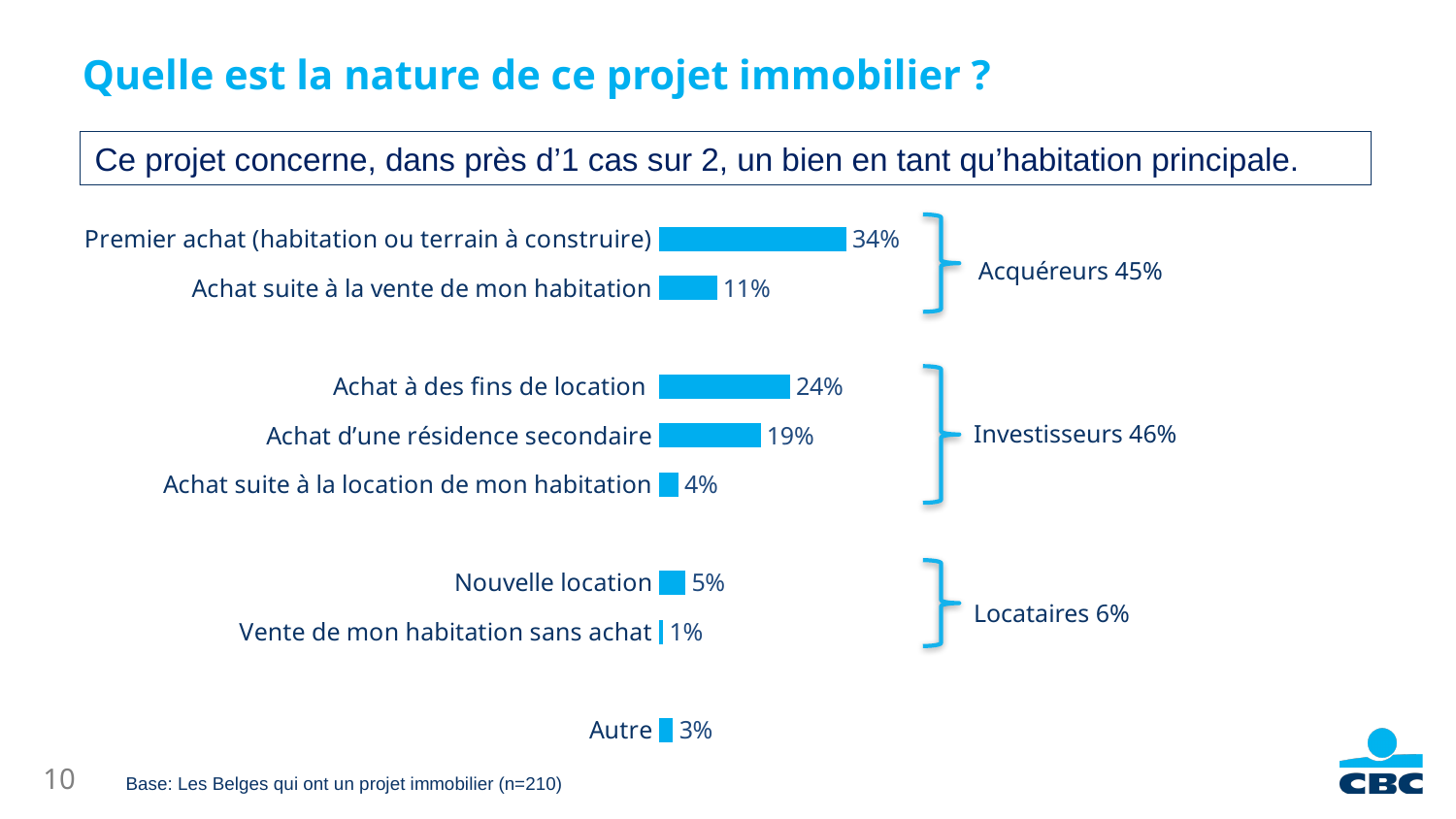
What is the combined value shown for the "Investisseurs" group? 46% Which is larger: "Achat à des fins de location" or "Achat d'une résidence secondaire"? Achat à des fins de location What is the title of the slide? Quelle est la nature de ce projet immobilier ? What is the value for "Premier achat (habitation ou terrain à construire)"? 34% What is the difference between "Achat à des fins de location" and "Achat suite à la vente de mon habitation"? 13% What kind of chart is shown on the slide? Bar chart What is the value for "Nouvelle location"? 5% What is the combined value shown for the "Acquéreurs" group? 45% What is the value for "Achat d'une résidence secondaire"? 19% How many categories are plotted in the chart? 8 Which category has the highest value? Premier achat (habitation ou terrain à construire) Which category has the lowest value? Vente de mon habitation sans achat